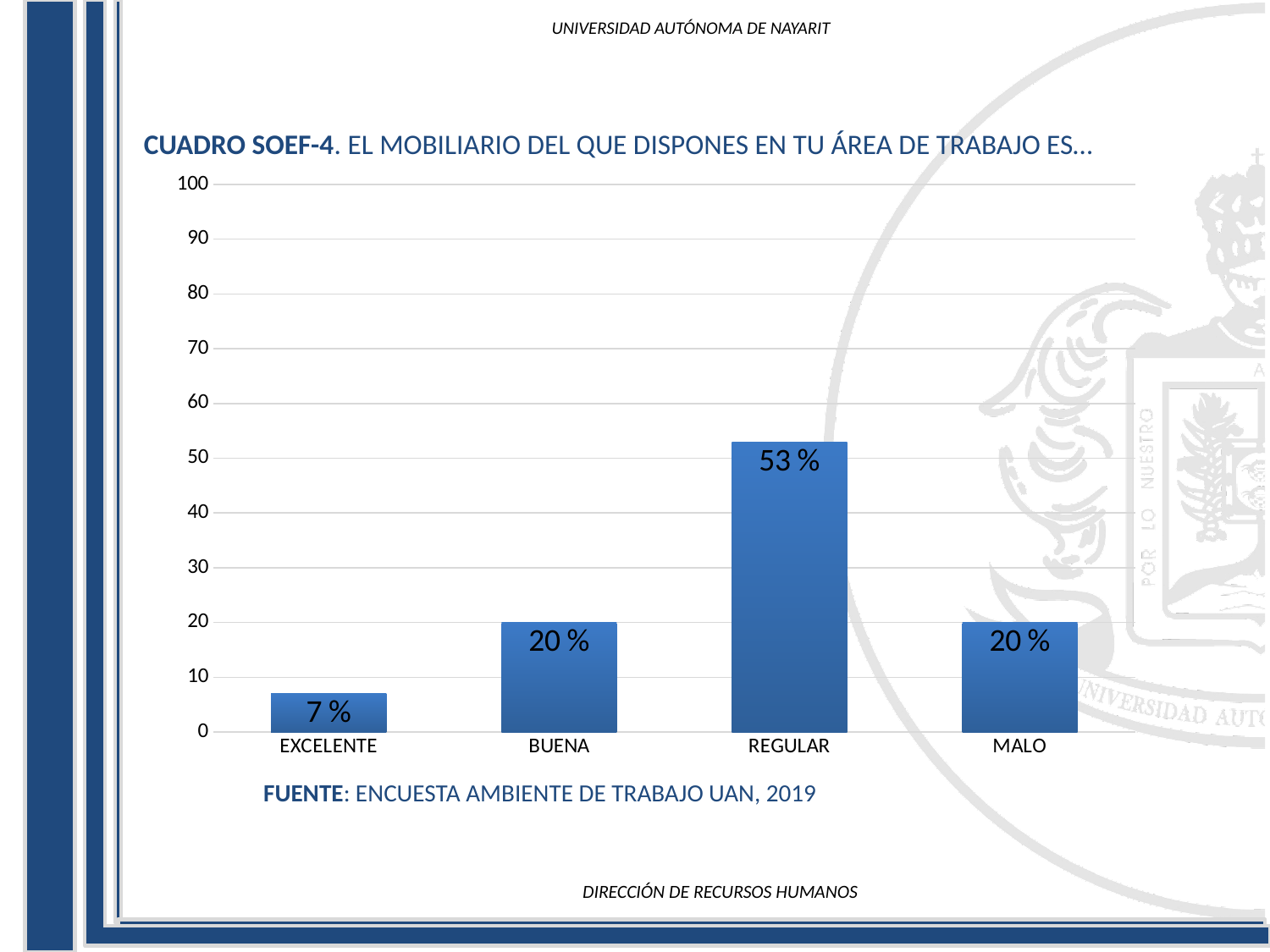
What is the value for EXCELENTE? 7 % How many categories are shown on the x axis? 4 Which category has the highest value? REGULAR Is the value for REGULAR greater or less than 50? greater What is the value for REGULAR? 53 % What is the value for BUENA? 20 % Which is larger, the value for REGULAR or the value for MALO? REGULAR What is the value for MALO? 20 % What kind of chart is shown on the slide? bar chart Which category has the lowest value? EXCELENTE What is the difference between the values for REGULAR and BUENA? 33 % What is the difference between the values for MALO and EXCELENTE? 13 %